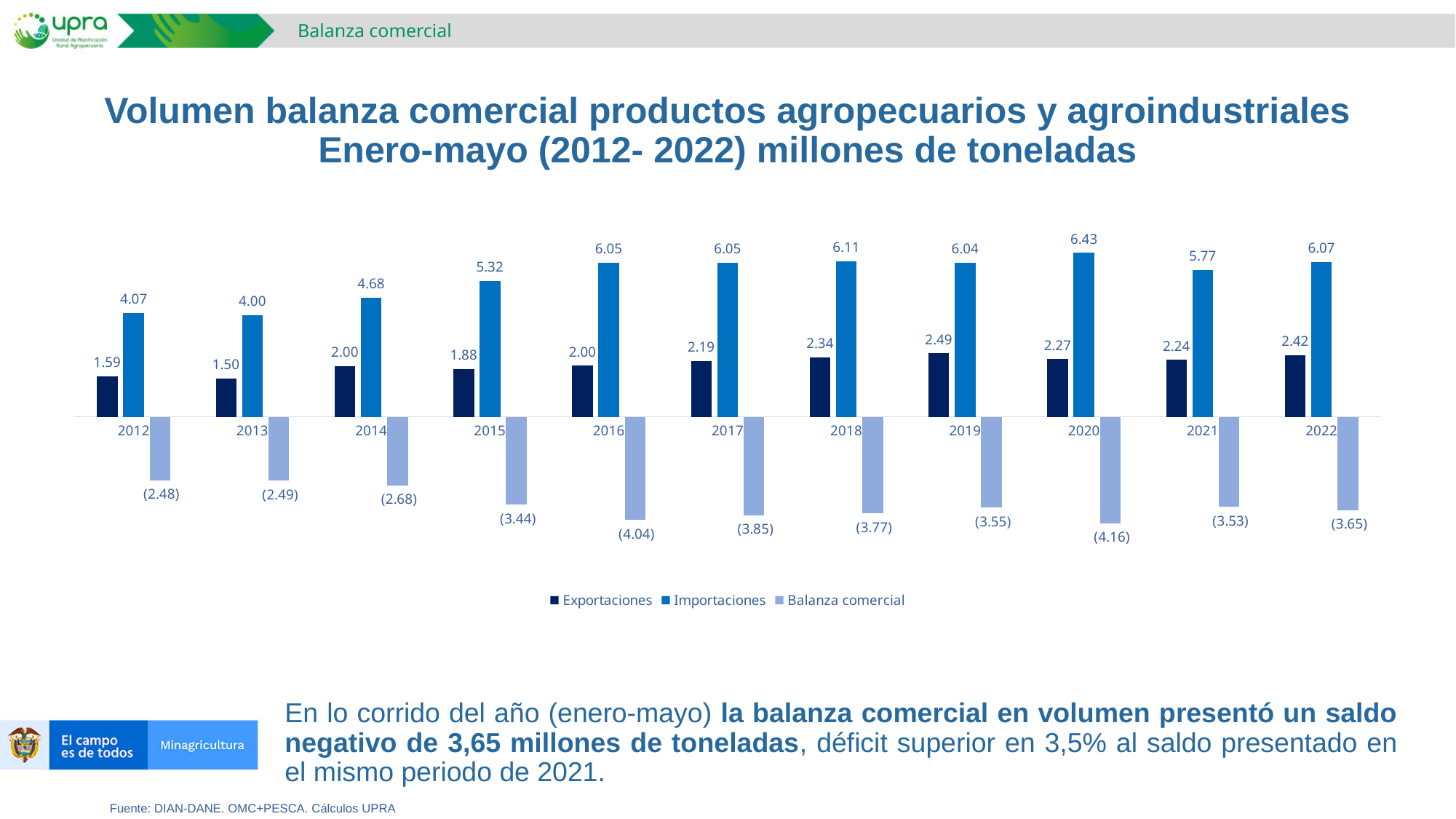
What is the difference between Importaciones and Exportaciones in 2022? 3.65 In which year is the Exportaciones value lowest? 2013 What is the value of Importaciones for 2020? 6.43 What is the value of Exportaciones for 2019? 2.49 What kind of chart is shown on the slide? Bar chart Which is larger, Importaciones in 2015 or Importaciones in 2021? Importaciones in 2021 Which series is shown in the light blue bars below the axis? Balanza comercial How many years are shown on the x axis of the chart? 11 Do the Importaciones values rise or fall from 2012 to 2016? Rise In which year is the Importaciones value highest? 2020 What is the Balanza comercial value shown for 2022? (3.65) How many series does the legend list? 3